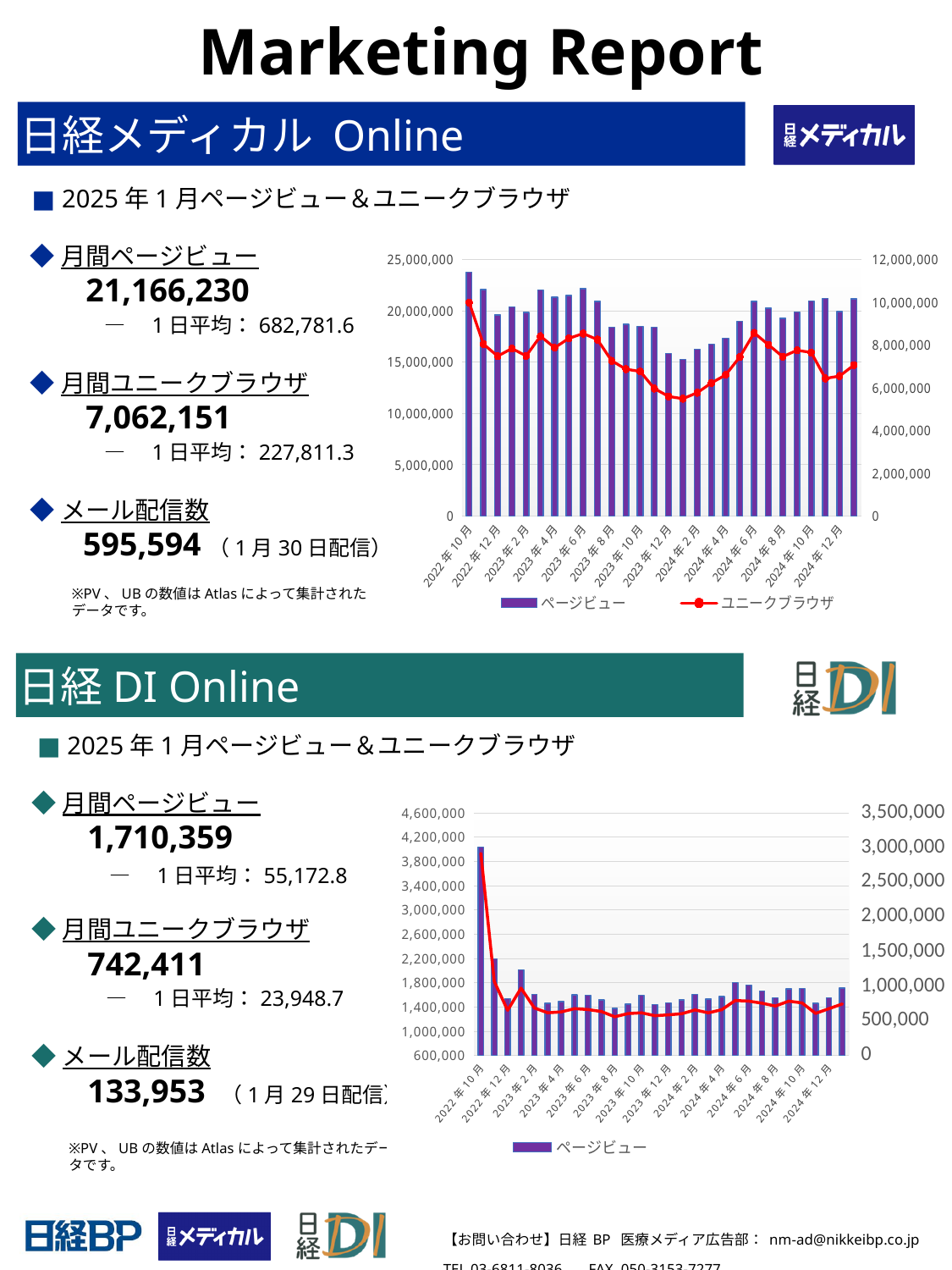
How many series does the legend of the top chart (日経メディカル Online) list? 2 In the top chart (日経メディカル Online), do page views rise or fall from 2022年10月 to 2024年1月? fall How many monthly bars are plotted in the top chart (日経メディカル Online)? 28 In the bottom chart (日経 DI Online), is the page view bar for 2022年10月 greater or less than 3,400,000? greater In the bottom chart (日経 DI Online), which page view bar is taller: 2022年10月 or 2022年12月? 2022年10月 In the bottom chart (日経 DI Online), which month has the highest page view bar? 2022年10月 What are the two legend entries of the top chart (日経メディカル Online)? ページビュー and ユニークブラウザ In the top chart (日経メディカル Online), is the page view bar for 2022年10月 greater or less than 20,000,000? greater In the top chart (日経メディカル Online), which page view bar is taller: 2022年10月 or 2024年1月? 2022年10月 In the top chart (日経メディカル Online), is the unique browser value for 2024年1月 greater or less than 8,000,000? less What kind of chart is shown for 日経メディカル Online (top chart)? Combined bar and line chart In the top chart (日経メディカル Online), which month has the highest page view bar? 2022年10月